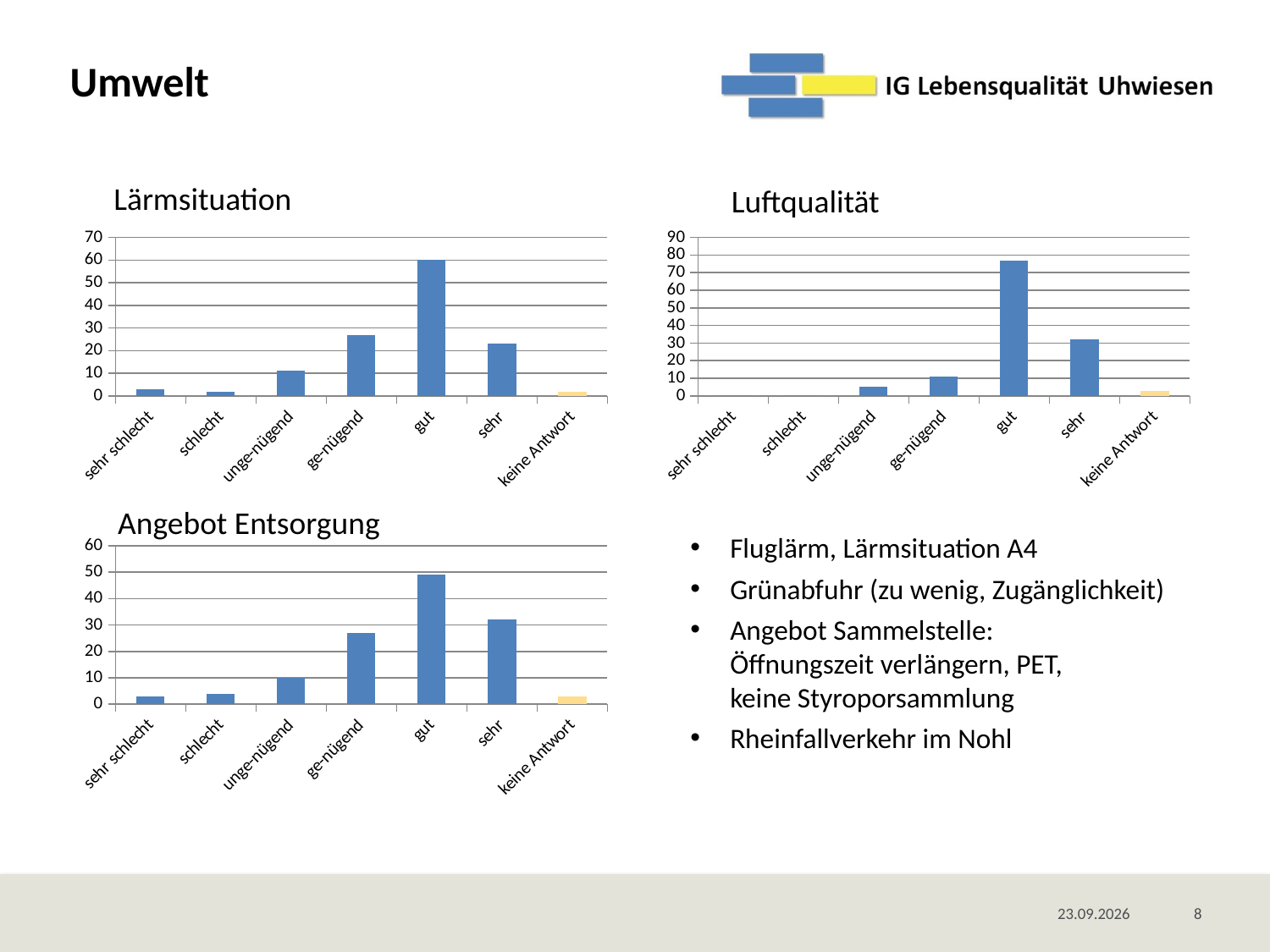
How many categories are shown on the x axis of the Luftqualität chart? 7 In the Lärmsituation chart, is the value for ge-nügend greater or less than 20? greater In the Angebot Entsorgung chart, which category has the highest value? gut In the Luftqualität chart, is the value for sehr greater or less than 40? less In the Angebot Entsorgung chart, is the value for gut greater or less than 40? greater In the Lärmsituation chart, which category has the highest value? gut What is the title of the chart in the bottom left of the slide? Angebot Entsorgung In the Luftqualität chart, which category has the highest value? gut What kind of chart is the Lärmsituation chart? bar chart In the Angebot Entsorgung chart, which is larger, the value for sehr or the value for ge-nügend? sehr In the Lärmsituation chart, which is larger, the value for ge-nügend or the value for sehr? ge-nügend